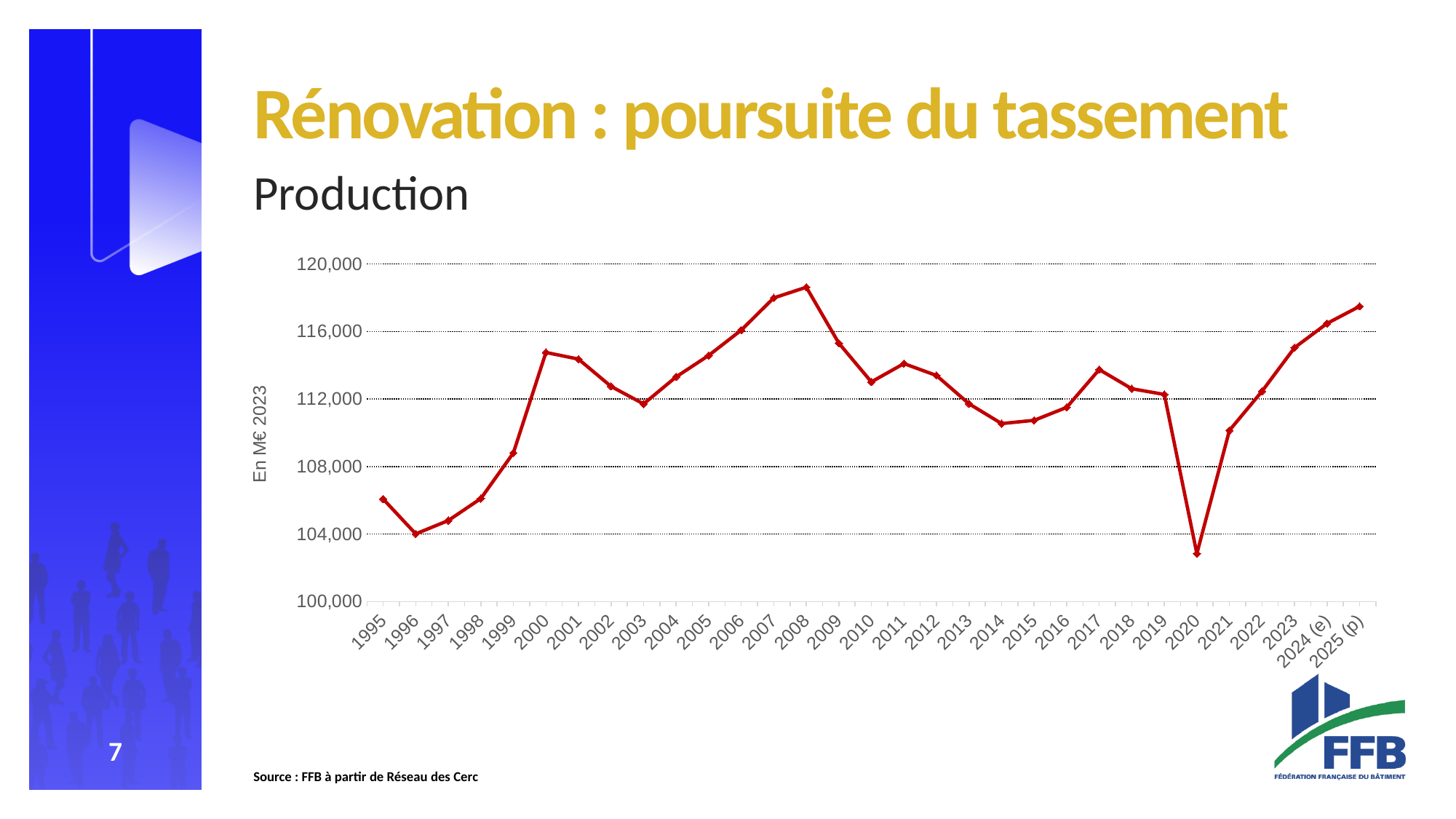
Is the value for 2008 greater or less than 116,000? greater What is the label on the y axis of the chart? En M€ 2023 Which year has the lowest production value in the chart? 2020 What kind of chart is shown on the slide? line chart Which year has the higher value, 2000 or 2003? 2000 Which year has the highest production value in the chart? 2008 Is the value for 1995 greater or less than 108,000? less Is the value for 2020 greater or less than 104,000? less How many years are plotted on the x axis of the chart? 31 Do the values rise or fall from 2020 to 2025 (p)? rise